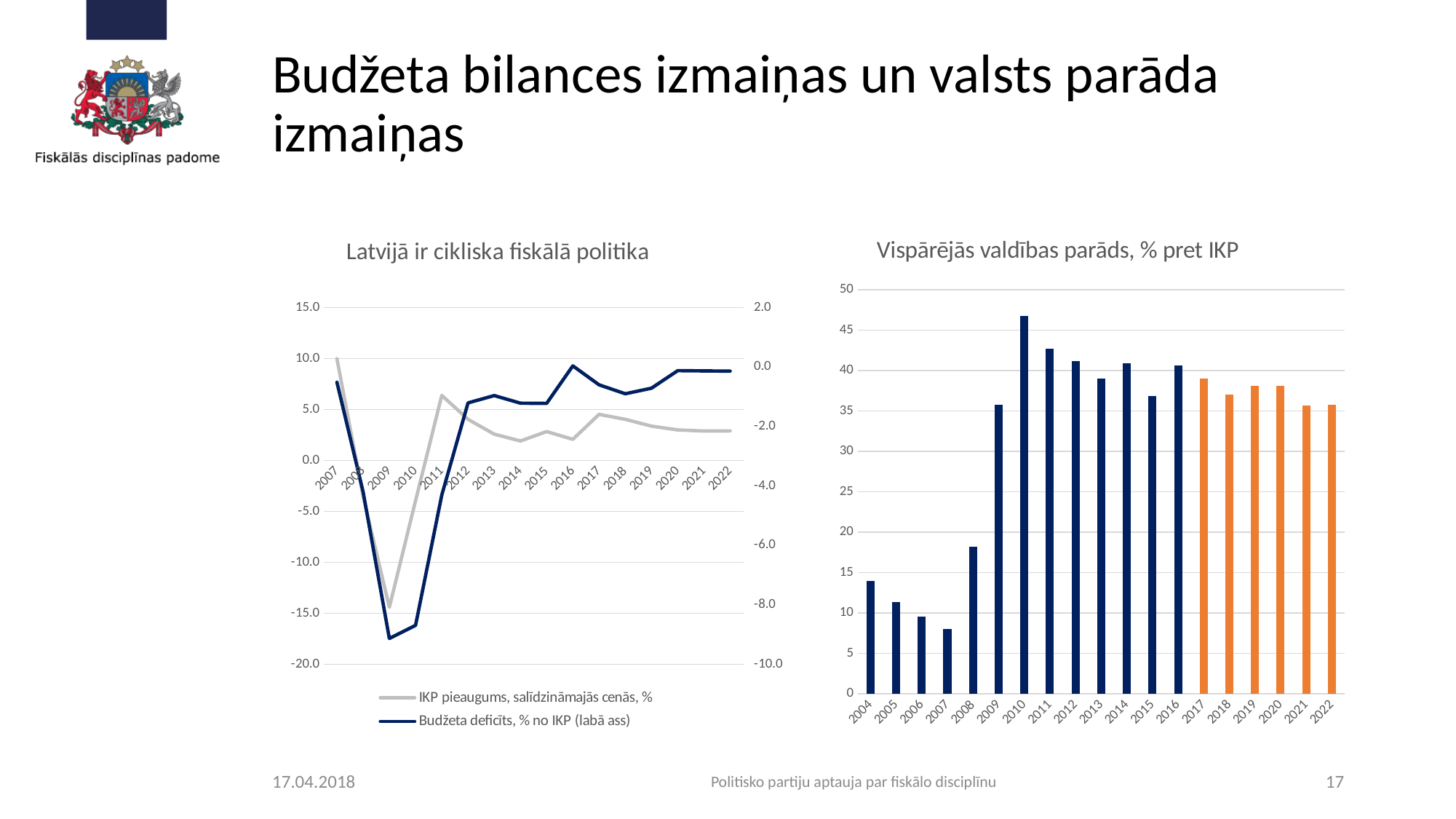
In the chart "Vispārējās valdības parāds, % pret IKP", which year has the lowest value? 2007 In the chart "Vispārējās valdības parāds, % pret IKP", is the value for 2004 greater or less than 15? less In the chart "Vispārējās valdības parāds, % pret IKP", which year has the highest value? 2010 In the chart "Vispārējās valdības parāds, % pret IKP", which is larger, the value for 2004 or the value for 2005? 2004 How many years are shown on the x axis of the chart "Vispārējās valdības parāds, % pret IKP"? 19 What kind of chart is the chart titled "Latvijā ir cikliska fiskālā politika"? line chart In the chart "Vispārējās valdības parāds, % pret IKP", is the value for 2010 greater or less than 45? greater What kind of chart is the chart titled "Vispārējās valdības parāds, % pret IKP"? bar chart In the chart "Latvijā ir cikliska fiskālā politika", does the series "IKP pieaugums, salīdzināmajās cenās, %" rise or fall from 2007 to 2009? fall In the chart "Latvijā ir cikliska fiskālā politika", in which year does the series "IKP pieaugums, salīdzināmajās cenās, %" reach its lowest value? 2009 In the chart "Vispārējās valdības parāds, % pret IKP", is the value for 2008 greater or less than 20? less How many series does the legend of the chart "Latvijā ir cikliska fiskālā politika" list? 2